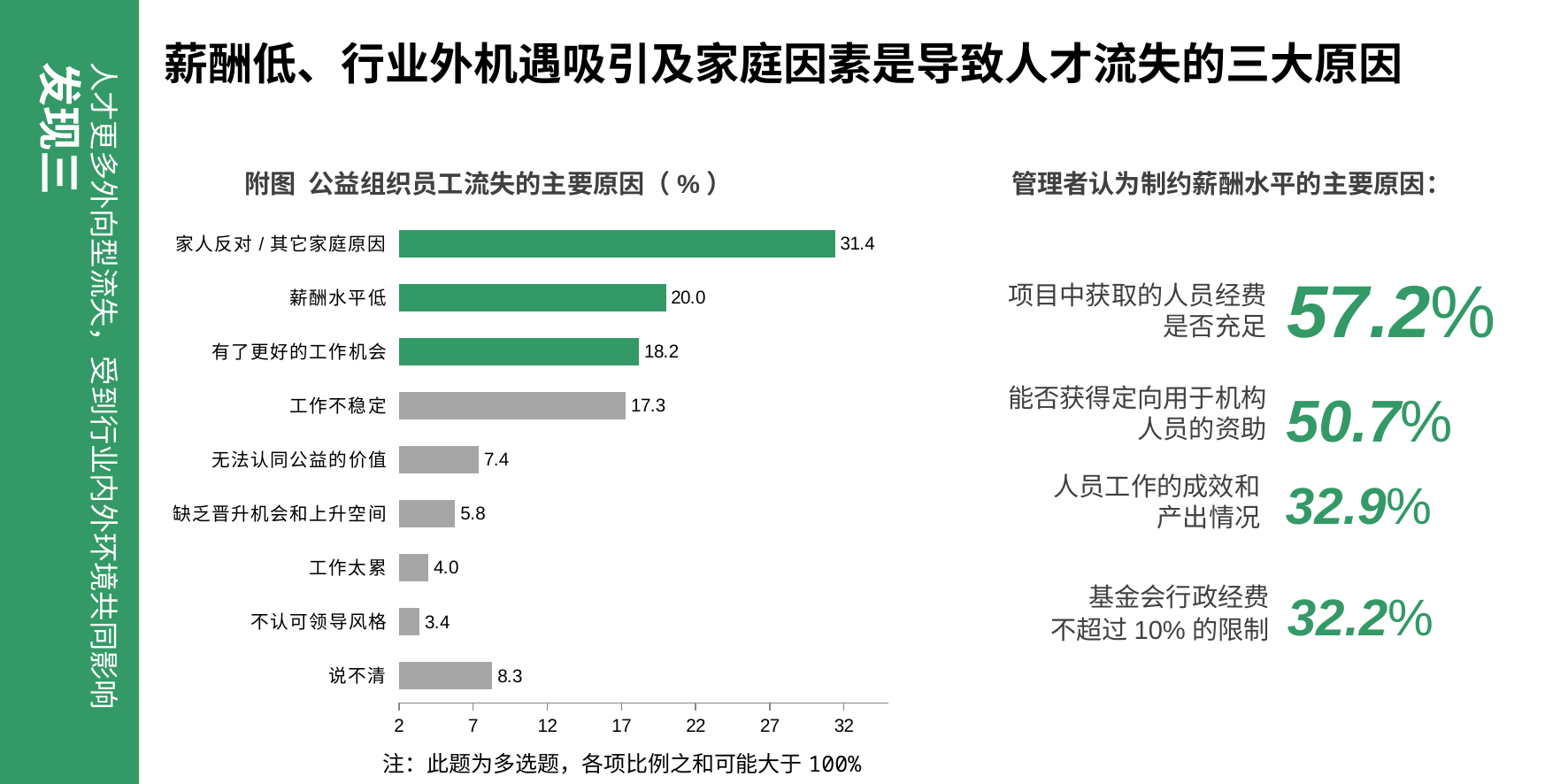
Which category has the lowest value in the chart? 不认可领导风格 What is the value for 家人反对 / 其它家庭原因 in the chart 公益组织员工流失的主要原因? 31.4 What is the value for 说不清? 8.3 What kind of chart is shown on the slide? bar chart What is the difference between the values for 薪酬水平低 and 有了更好的工作机会? 1.8 Is the value for 工作不稳定 greater or less than 12? greater How many categories are shown in the chart? 9 Which is larger, the value for 无法认同公益的价值 or the value for 说不清? 说不清 Which category has the highest value in the chart? 家人反对 / 其它家庭原因 How many bars in the chart are coloured green? 3 What is the value for 工作不稳定? 17.3 What is the value for 薪酬水平低? 20.0